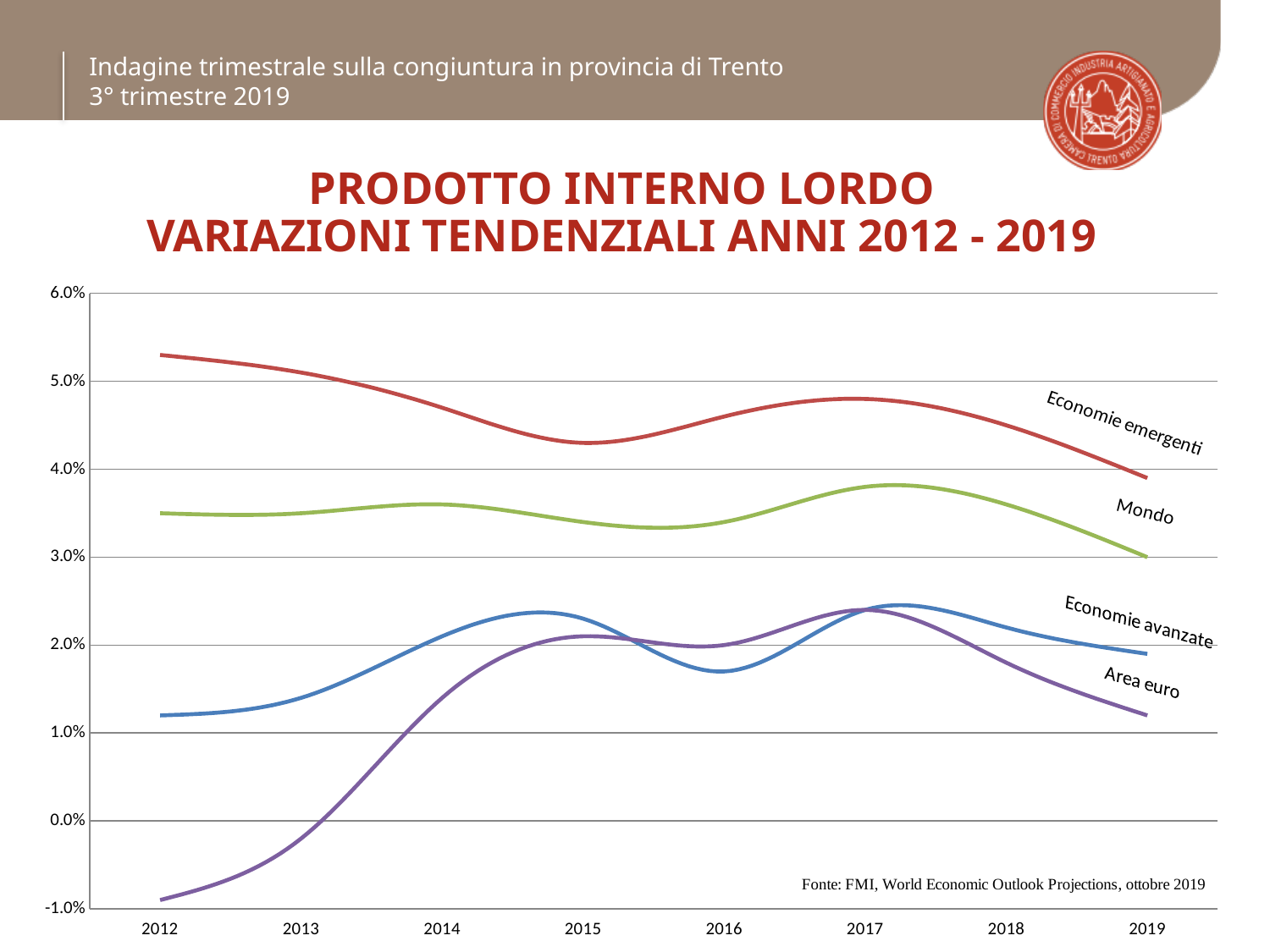
Is the value for Economie emergenti in 2012 greater or less than 5.0%? greater Is the value for Area euro in 2012 greater or less than 0.0%? less Is the value for Economie emergenti in 2019 greater or less than 4.0%? less Does the Economie emergenti line rise or fall from 2012 to 2015? fall Which series has the lowest value in 2012? Area euro What kind of chart is shown on the slide? line chart In 2019, which is larger: the value for Economie avanzate or the value for Area euro? Economie avanzate How many years are shown on the x axis of the chart? 8 How many series are plotted on the chart? 4 Which series has the highest value in 2012? Economie emergenti What source is cited for the chart data? FMI, World Economic Outlook Projections, ottobre 2019